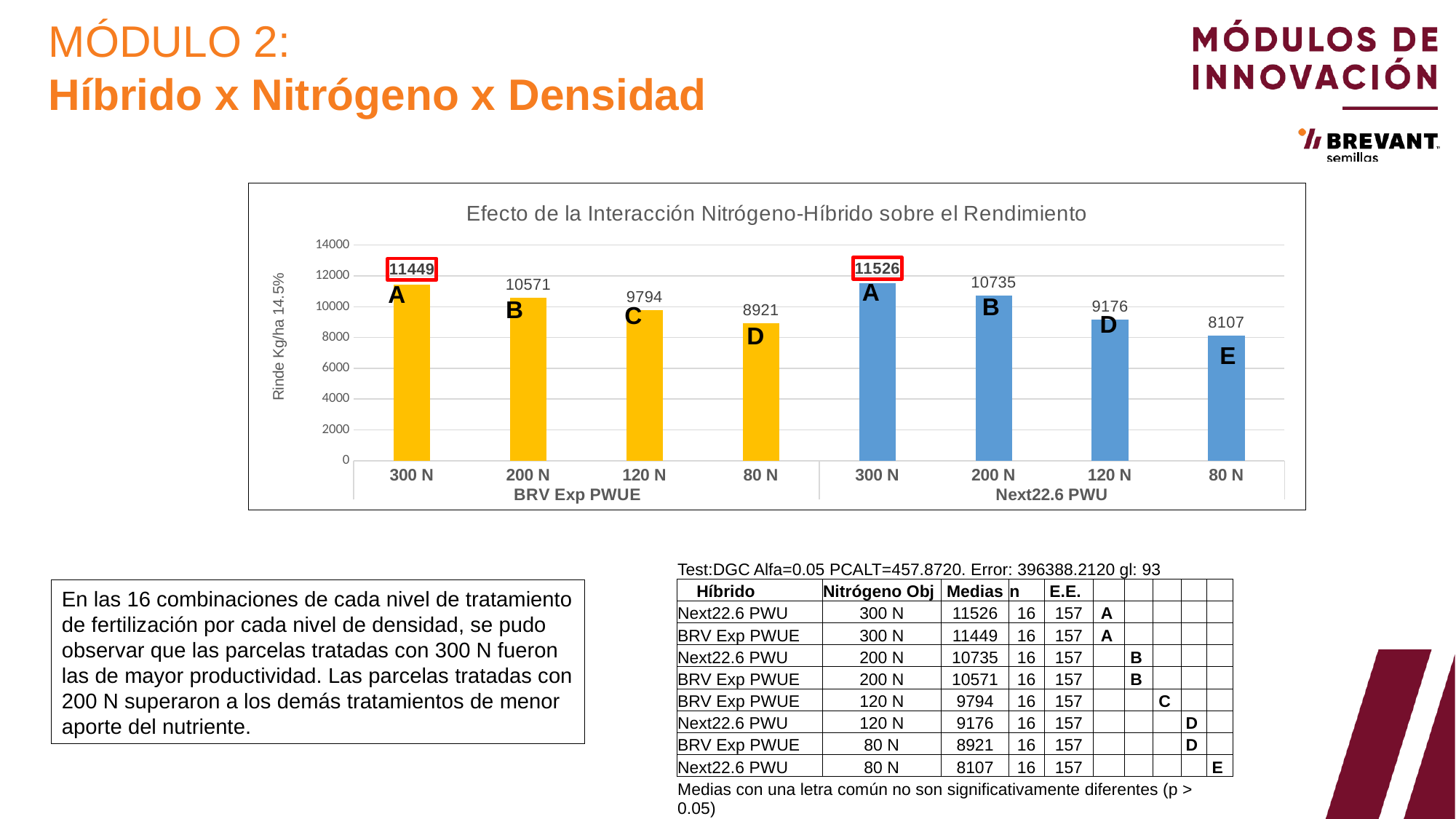
Which is larger: the 200 N value for BRV Exp PWUE or the 200 N value for Next22.6 PWU? Next22.6 PWU What is the value for 80 N under Next22.6 PWU? 8107 What kind of chart is shown on the slide? Bar chart What is the difference between the 300 N and 80 N values for BRV Exp PWUE? 2528 How many bars are plotted in the chart? 8 Within each hybrid group, do the values rise or fall as nitrogen goes from 300 N to 80 N? Fall What is the value for 200 N under Next22.6 PWU? 10735 What is the value for 300 N under BRV Exp PWUE? 11449 Which bar has the highest value in the chart? 300 N (Next22.6 PWU) What is the difference between the 120 N values for BRV Exp PWUE and Next22.6 PWU? 618 What is the title of the chart? Efecto de la Interacción Nitrógeno-Híbrido sobre el Rendimiento Which bar has the lowest value in the chart? 80 N (Next22.6 PWU)